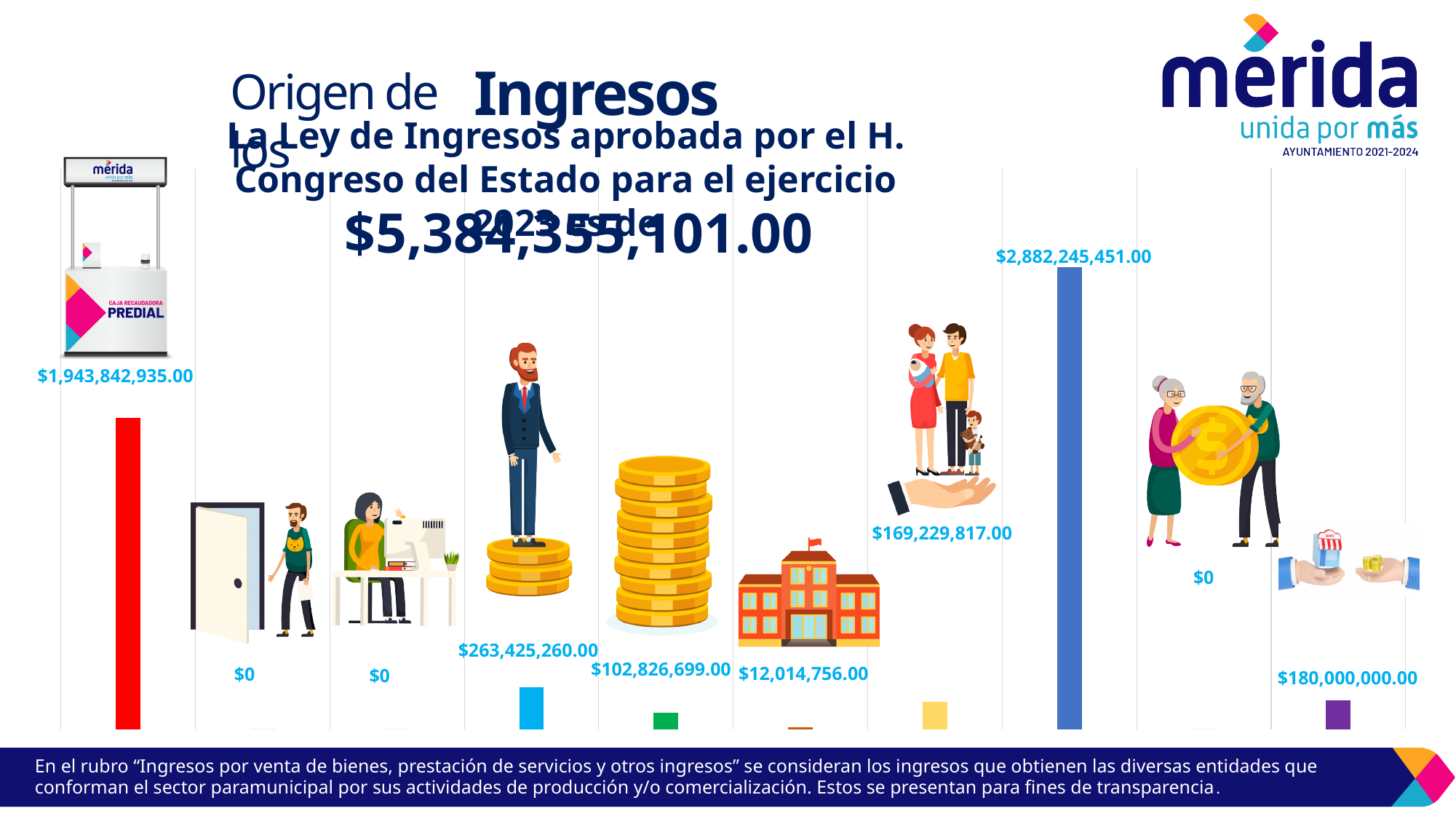
What is the difference between the light blue bar ($263,425,260.00) and the green bar ($102,826,699.00)? $160,598,561.00 What is the value labelled on the light blue bar, the fourth from the left? $263,425,260.00 What is the value labelled on the leftmost (red) bar of the chart? $1,943,842,935.00 What kind of chart is shown on the slide? bar chart How many bars in the chart are labelled $0? 3 According to the slide's heading, what is the total of the Ley de Ingresos for the 2023 fiscal year? $5,384,355,101.00 How many bars (categories) does the chart show? 10 Which is larger, the green bar ($102,826,699.00) or the brown bar ($12,014,756.00)? the green bar ($102,826,699.00) What is the difference between the tallest bar ($2,882,245,451.00) and the red bar ($1,943,842,935.00)? $938,402,516.00 What is the value labelled on the rightmost (purple) bar of the chart? $180,000,000.00 What is the value labelled on the yellow bar of the chart? $169,229,817.00 What is the value labelled on the tallest bar of the chart? $2,882,245,451.00